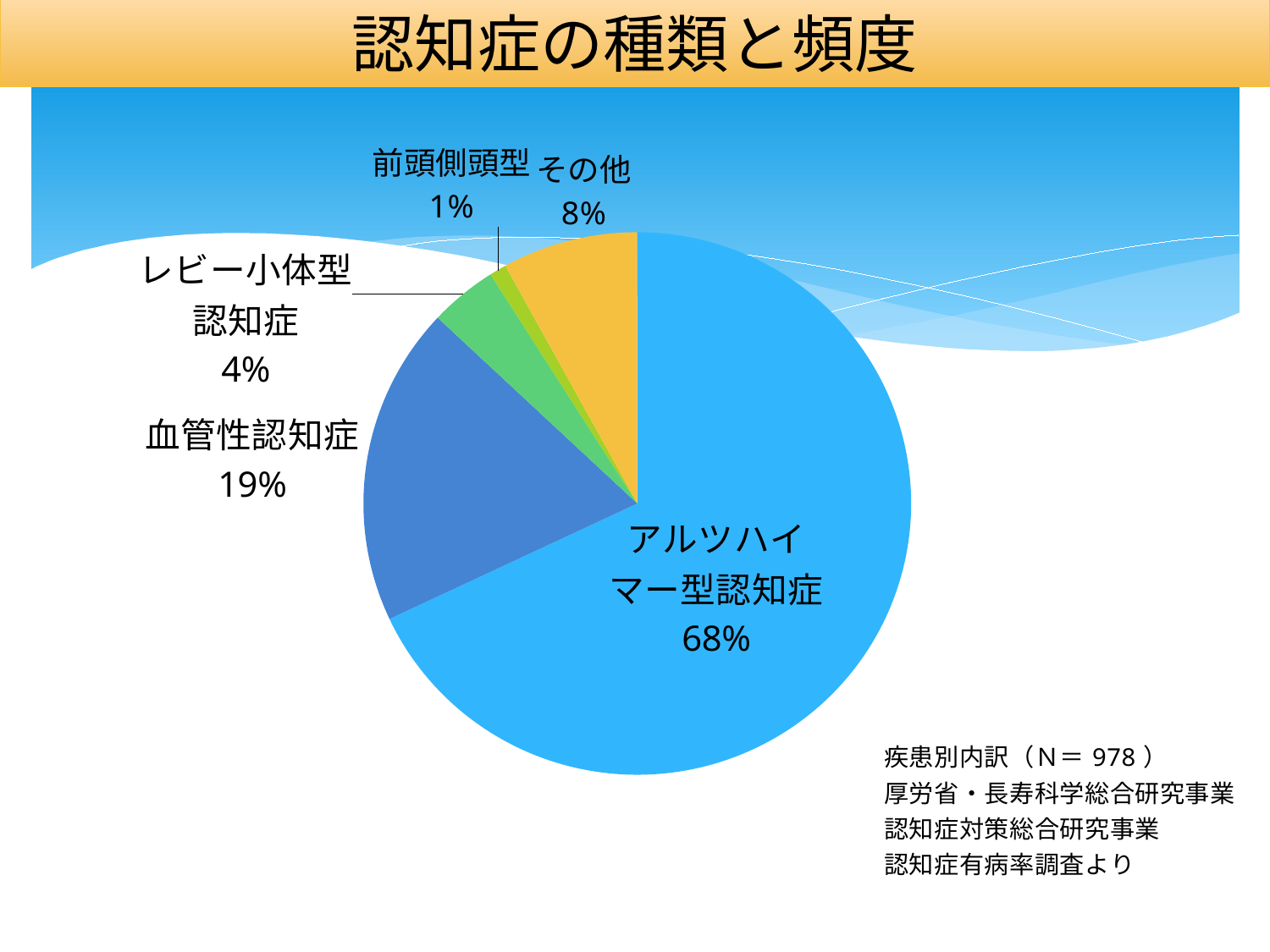
What is the difference in percentage points between アルツハイマー型認知症 and 血管性認知症? 49 Which is larger, その他 or レビー小体型認知症? その他 How many categories are shown in the pie chart? 5 What is the value shown for その他? 8% What is the value shown for 血管性認知症? 19% What is the title of the slide? 認知症の種類と頻度 What kind of chart is shown on the slide? pie chart What is the value shown for 前頭側頭型? 1% What is the value shown for レビー小体型認知症? 4% Which category has the largest slice of the pie? アルツハイマー型認知症 What share of the pie does アルツハイマー型認知症 represent? 68% Which category has the smallest slice of the pie? 前頭側頭型